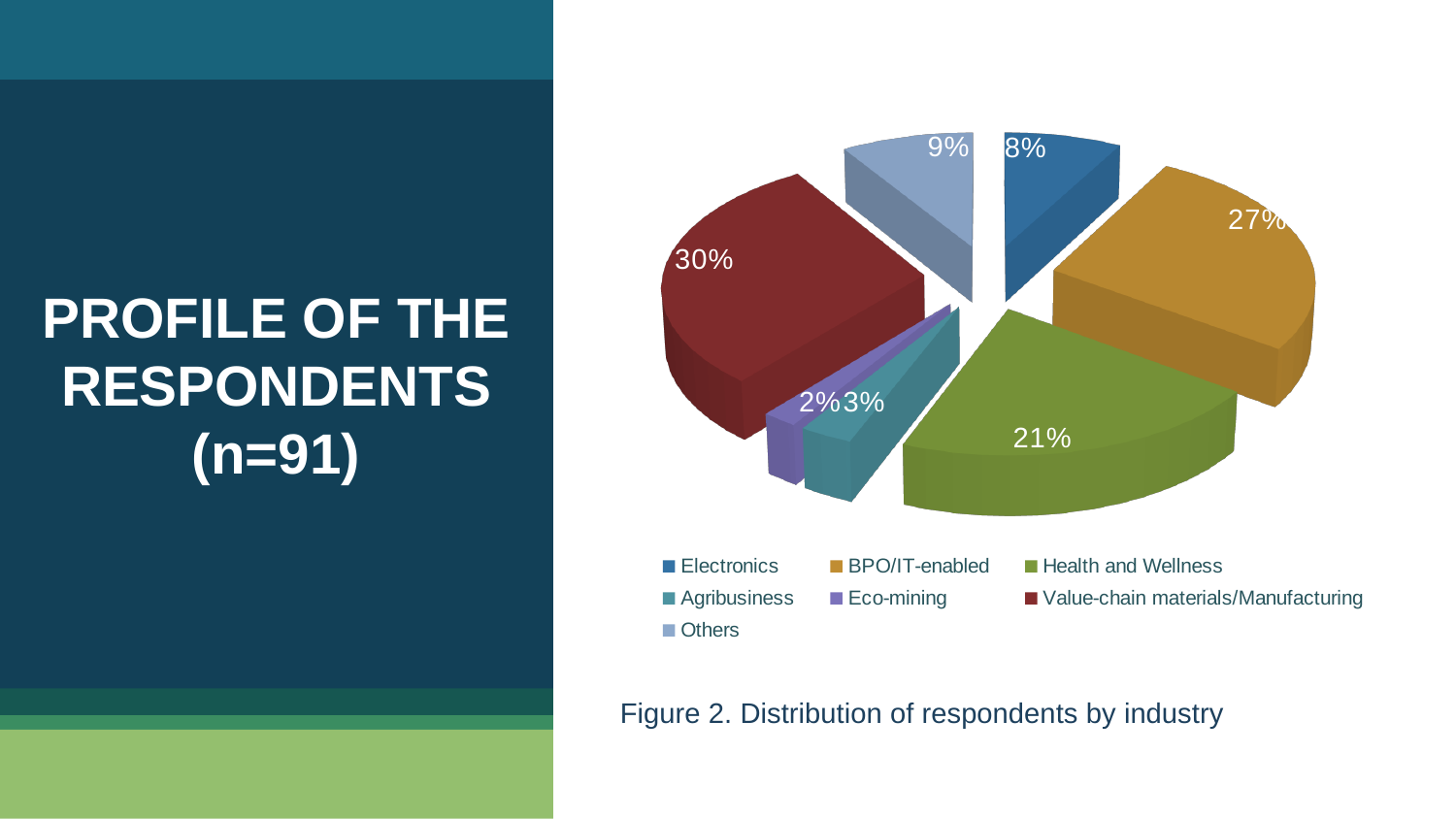
Which industry has the largest share of respondents? Value-chain materials/Manufacturing Which has a larger share of respondents, Health and Wellness or Others? Health and Wellness Which industry has the smallest share of respondents? Eco-mining What is the difference between the shares for Value-chain materials/Manufacturing and BPO/IT-enabled? 3% What share of respondents are in the Value-chain materials/Manufacturing industry? 30% What share of respondents are in the BPO/IT-enabled industry? 27% What share of respondents are in the Health and Wellness industry? 21% How many industry categories does the legend list? 7 What share of respondents are in the Electronics industry? 8% What is the caption of the figure below the chart? Figure 2. Distribution of respondents by industry What share of respondents fall under Others? 9% What kind of chart is shown on the slide? pie chart